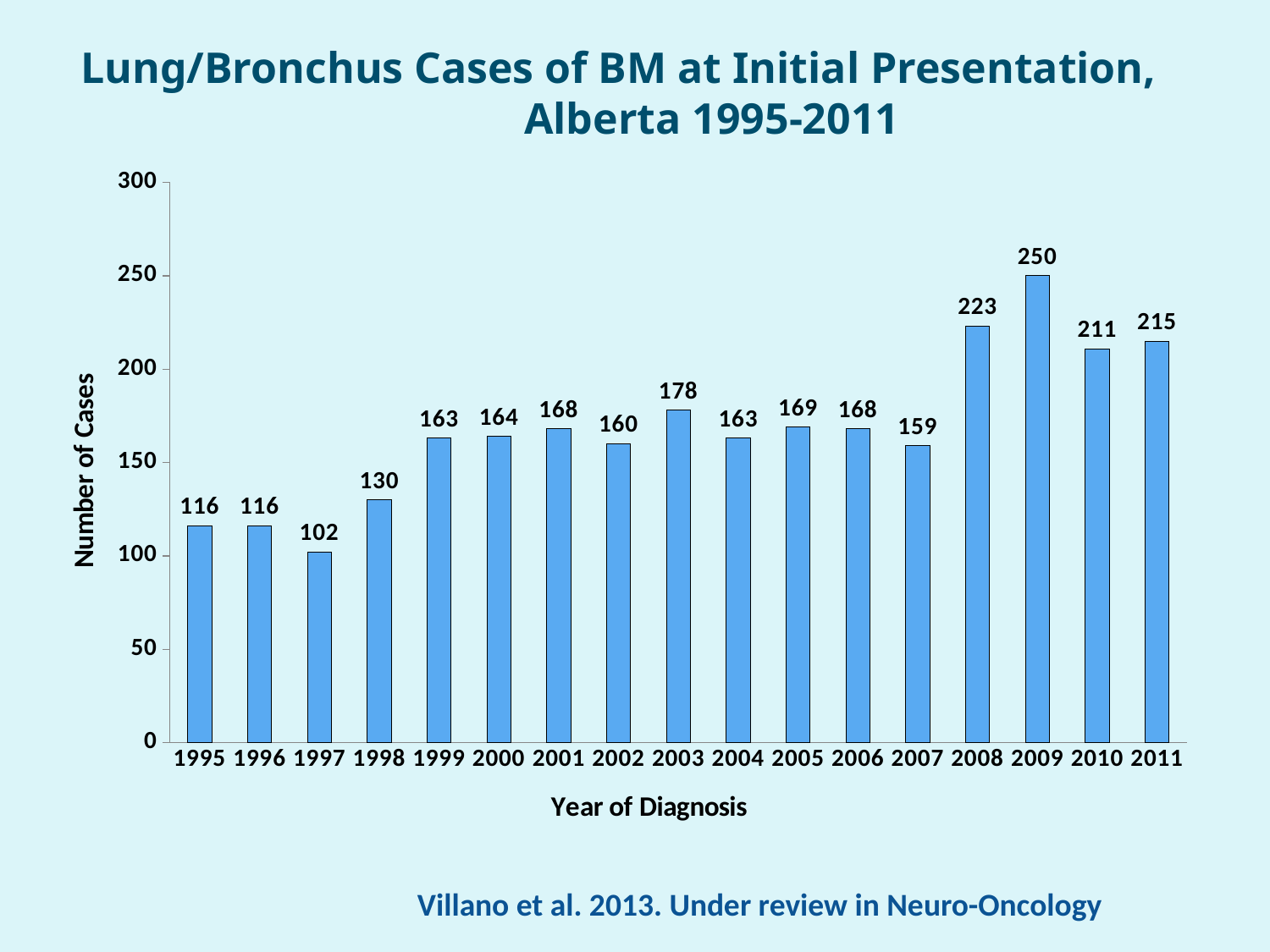
What is the number of cases in 2003? 178 Is the value for 2008 greater or less than 200? greater What is the difference in number of cases between 2009 and 2008? 27 Which year has the highest number of cases? 2009 What is the label of the y axis? Number of Cases Which year has more cases, 2010 or 2011? 2011 What is the number of cases in 1997? 102 How many years are shown on the x axis? 17 Which year has the lowest number of cases? 1997 What is the number of cases in 2009? 250 What kind of chart is shown on the slide? Bar chart What is the difference in number of cases between 2011 and 1995? 99